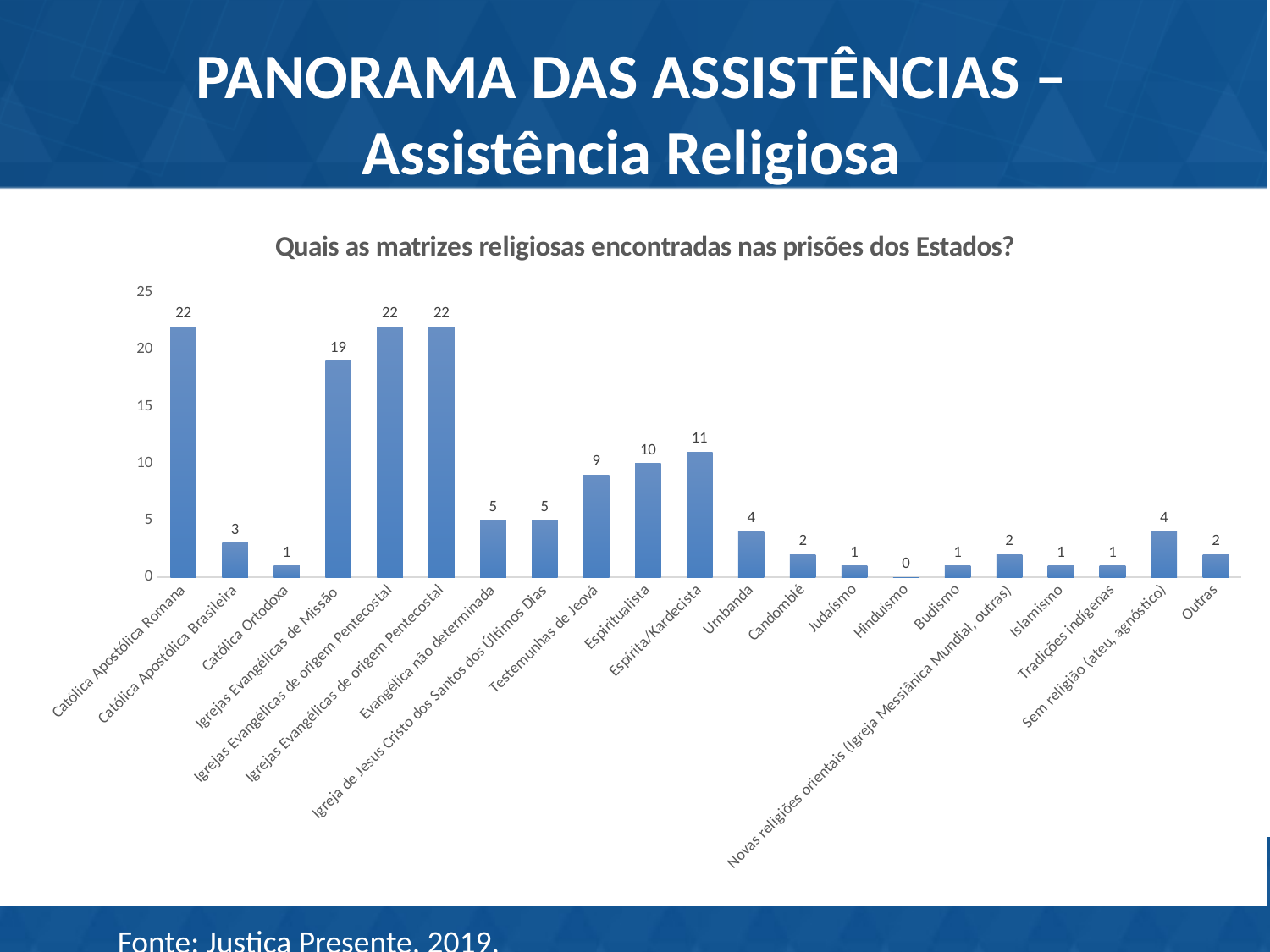
What is the value for Espírita/Kardecista? 11 What is the value for Católica Apostólica Romana? 22 What is the value for Igrejas Evangélicas de Missão? 19 What is the title of the chart? Quais as matrizes religiosas encontradas nas prisões dos Estados? How many categories are shown on the x axis? 21 Is the value for Católica Apostólica Romana greater or less than 20? greater What is the value for Testemunhas de Jeová? 9 What is the difference between the values for Igrejas Evangélicas de Missão and Espiritualista? 9 Which is larger, the value for Candomblé or the value for Sem religião (ateu, agnóstico)? Sem religião (ateu, agnóstico) What kind of chart is shown on the slide? Bar chart What is the value for Umbanda? 4 Which category has the lowest value? Hinduísmo